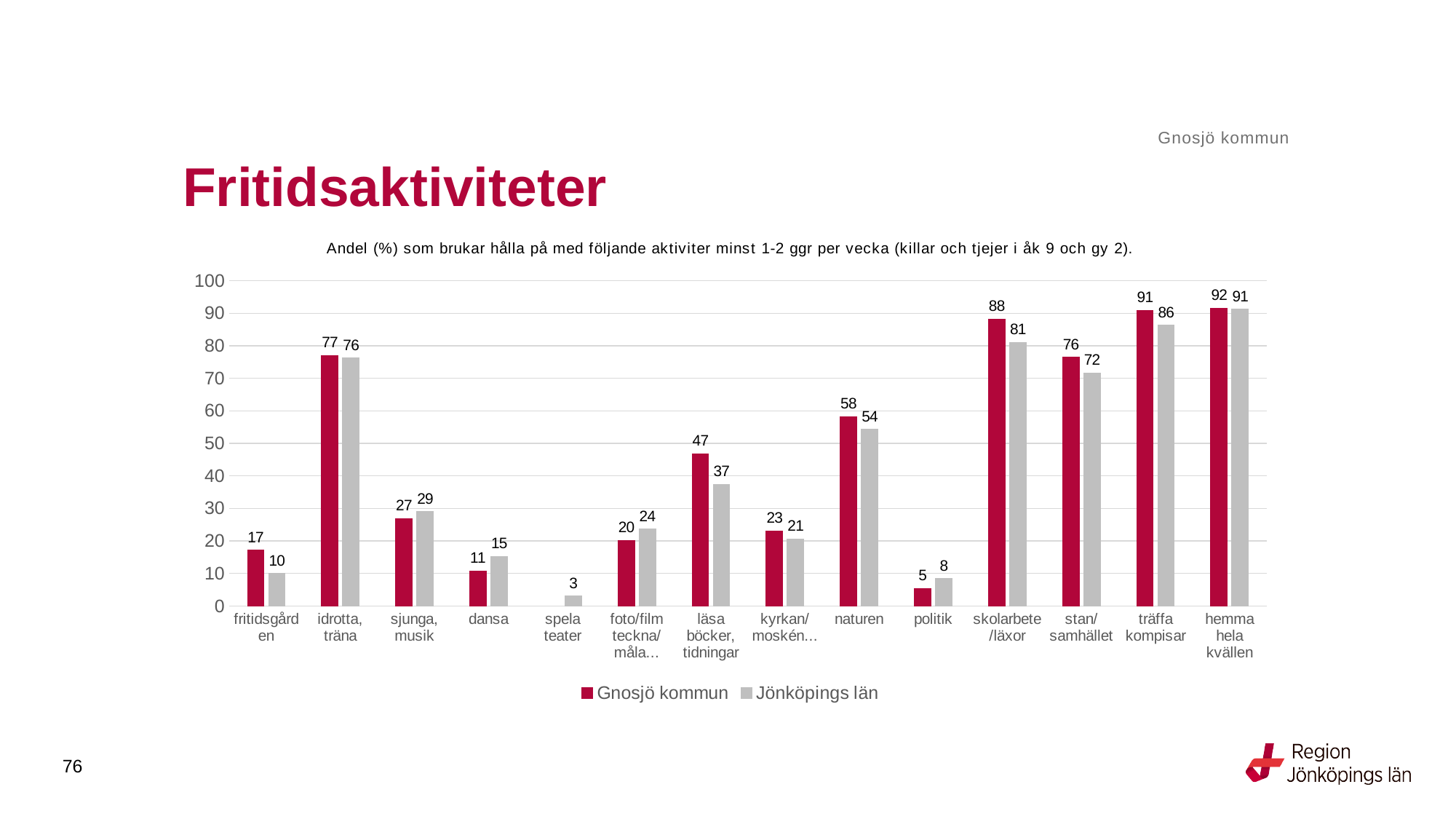
What is the difference between Gnosjö kommun and Jönköpings län for 'skolarbete/läxor'? 7 Which series is shown in red in the legend? Gnosjö kommun What is the difference between Gnosjö kommun and Jönköpings län for 'läsa böcker, tidningar'? 10 What is the value for Jönköpings län for 'läsa böcker, tidningar'? 37 How many series does the legend list? 2 For 'sjunga, musik', which is larger: Gnosjö kommun or Jönköpings län? Jönköpings län Which activity has the lowest value for Jönköpings län? spela teater What is the value for Gnosjö kommun for 'naturen'? 58 How many activity categories are shown on the x axis? 14 What kind of chart is shown on the slide? bar chart What is the value for Gnosjö kommun for 'politik'? 5 Which activity has the highest value for Gnosjö kommun? hemma hela kvällen